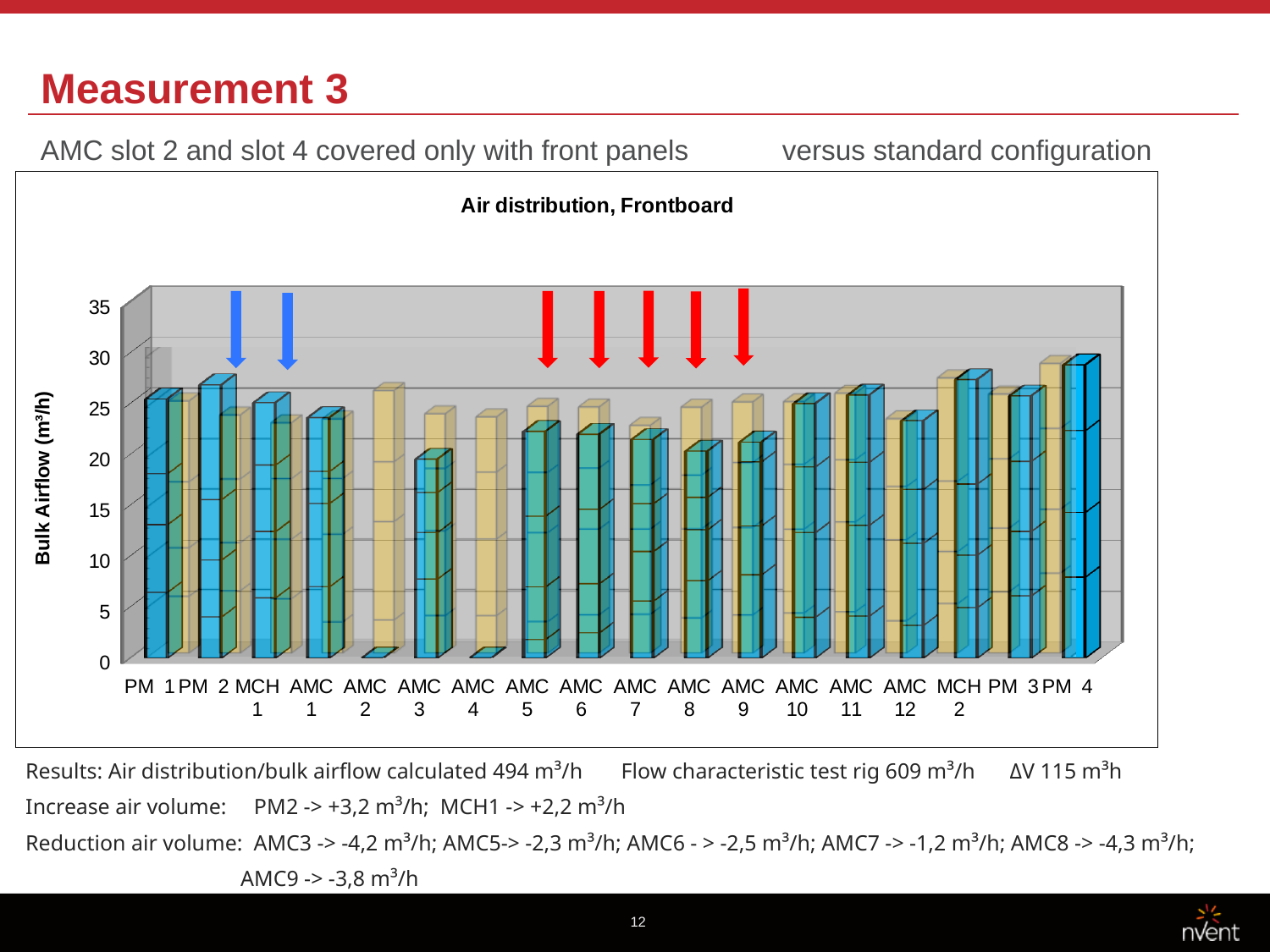
What is the title of the chart? Air distribution, Frontboard Is the blue bar for AMC 4 greater or less than 5? less Which category has the tallest blue bar? PM 4 What kind of chart is shown on the slide? bar chart Is the blue bar for AMC 3 greater or less than 25? less Which has the taller blue bar, AMC 2 or AMC 3? AMC 3 Is the blue bar for AMC 8 greater or less than 25? less How many categories are shown along the x axis of the chart? 18 What is the label of the vertical axis of the chart? Bulk Airflow (m³/h) Which has the taller blue bar, AMC 3 or AMC 5? AMC 5